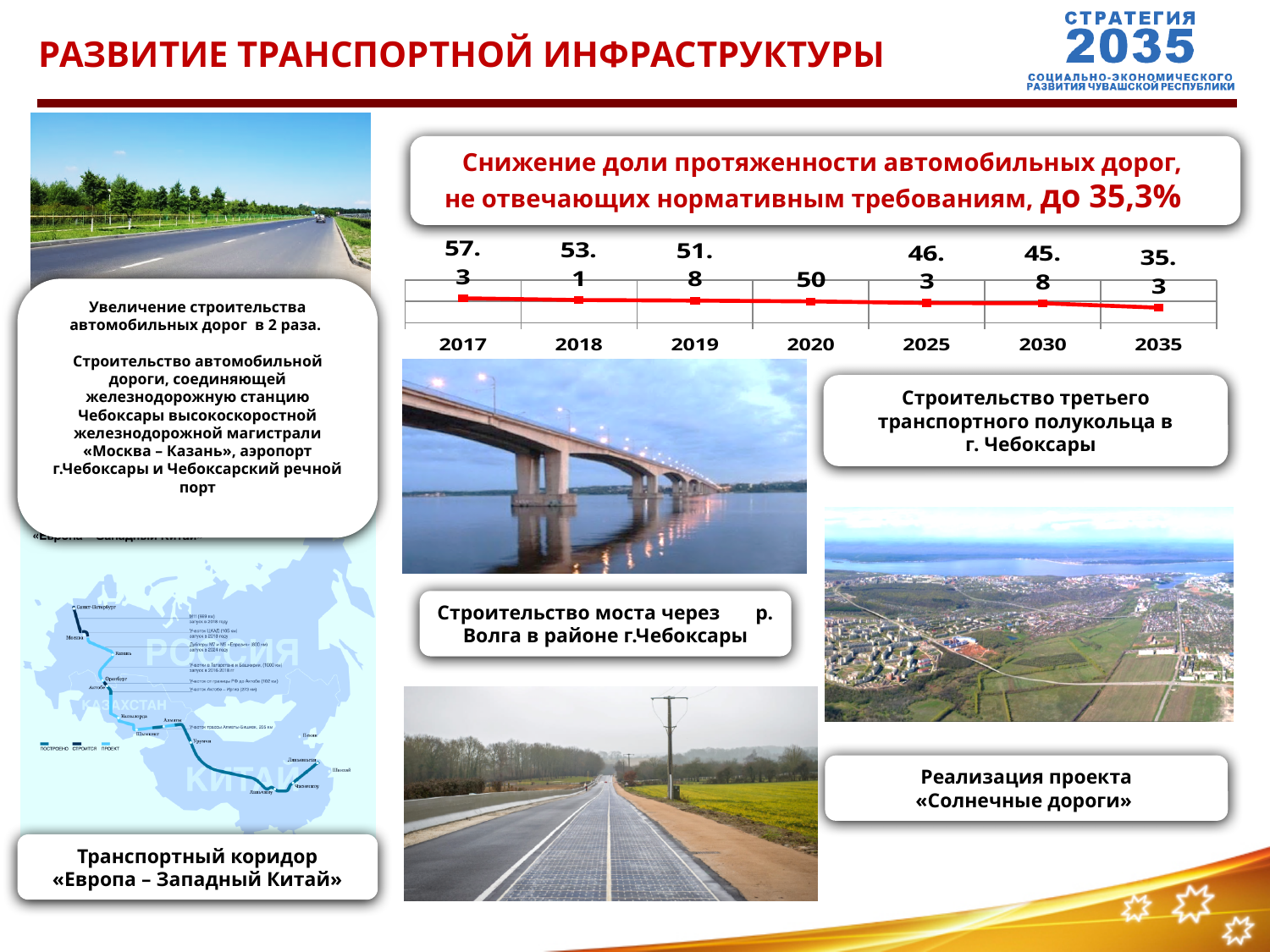
What is the value plotted for 2017? 57.3 How many data points are plotted on the chart? 7 What is the value plotted for 2020? 50 What is the difference between the values for 2018 and 2019? 1.3 What type of chart is shown on the slide? line chart Which year has the lowest value on the chart? 2035 What is the value plotted for 2025? 46.3 What is the difference between the values for 2017 and 2035? 22 Which is larger, the value for 2019 or the value for 2030? 2019 What is the value plotted for 2035? 35.3 Do the values rise or fall from 2017 to 2035? fall Which year has the highest value on the chart? 2017